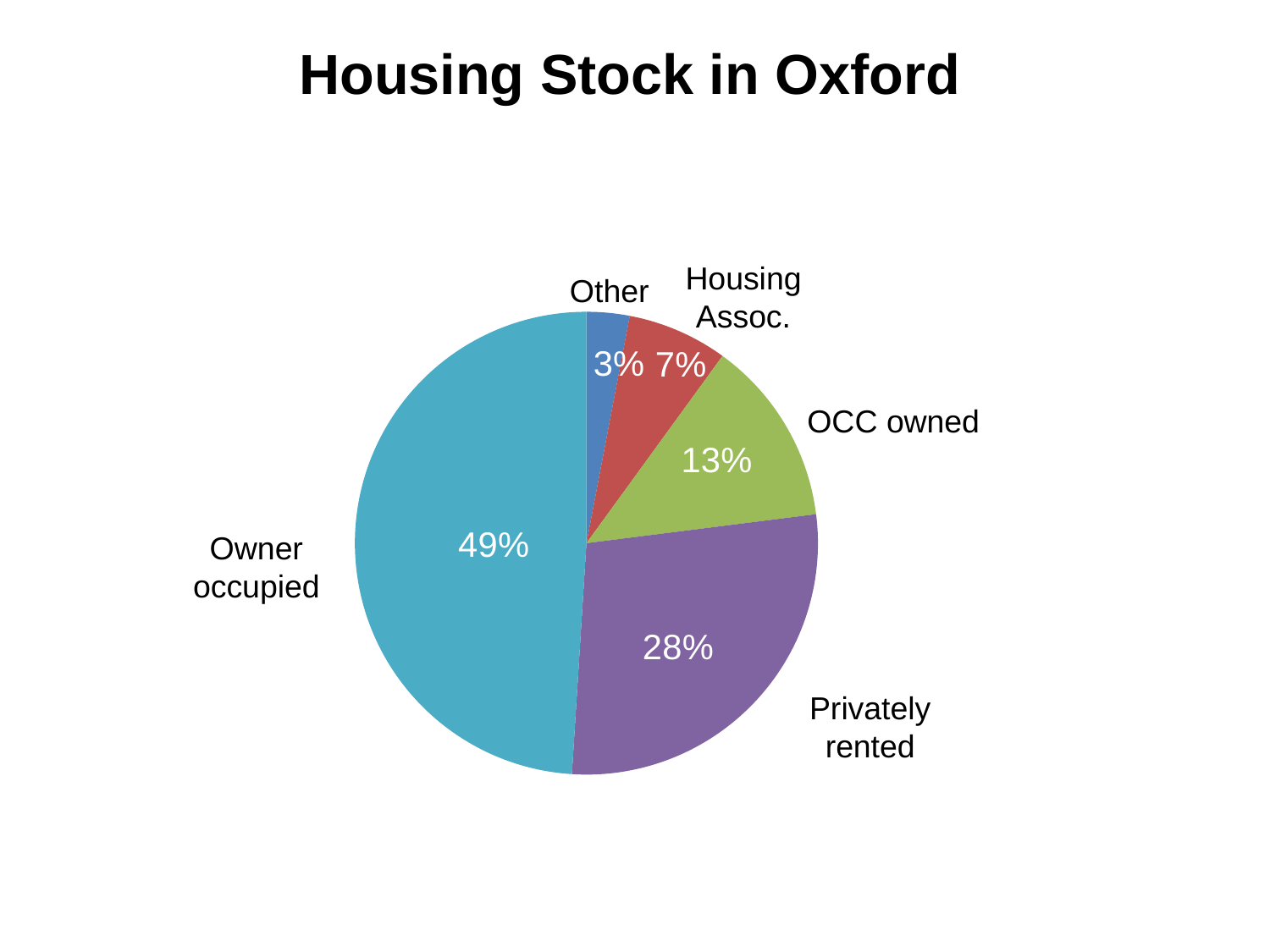
What share of the housing stock is Housing Assoc.? 7% Which category has the smallest share of the pie? Other What kind of chart is shown on the slide? Pie chart What is the difference in percentage points between Owner occupied and Privately rented? 21 What share of the housing stock is owner occupied? 49% Which is larger, OCC owned or Housing Assoc.? OCC owned What share of the housing stock is privately rented? 28% What share of the housing stock is labelled Other? 3% Which category has the largest share of the pie? Owner occupied What is the title of the chart? Housing Stock in Oxford How many slices does the pie chart have? 5 What share of the housing stock is OCC owned? 13%